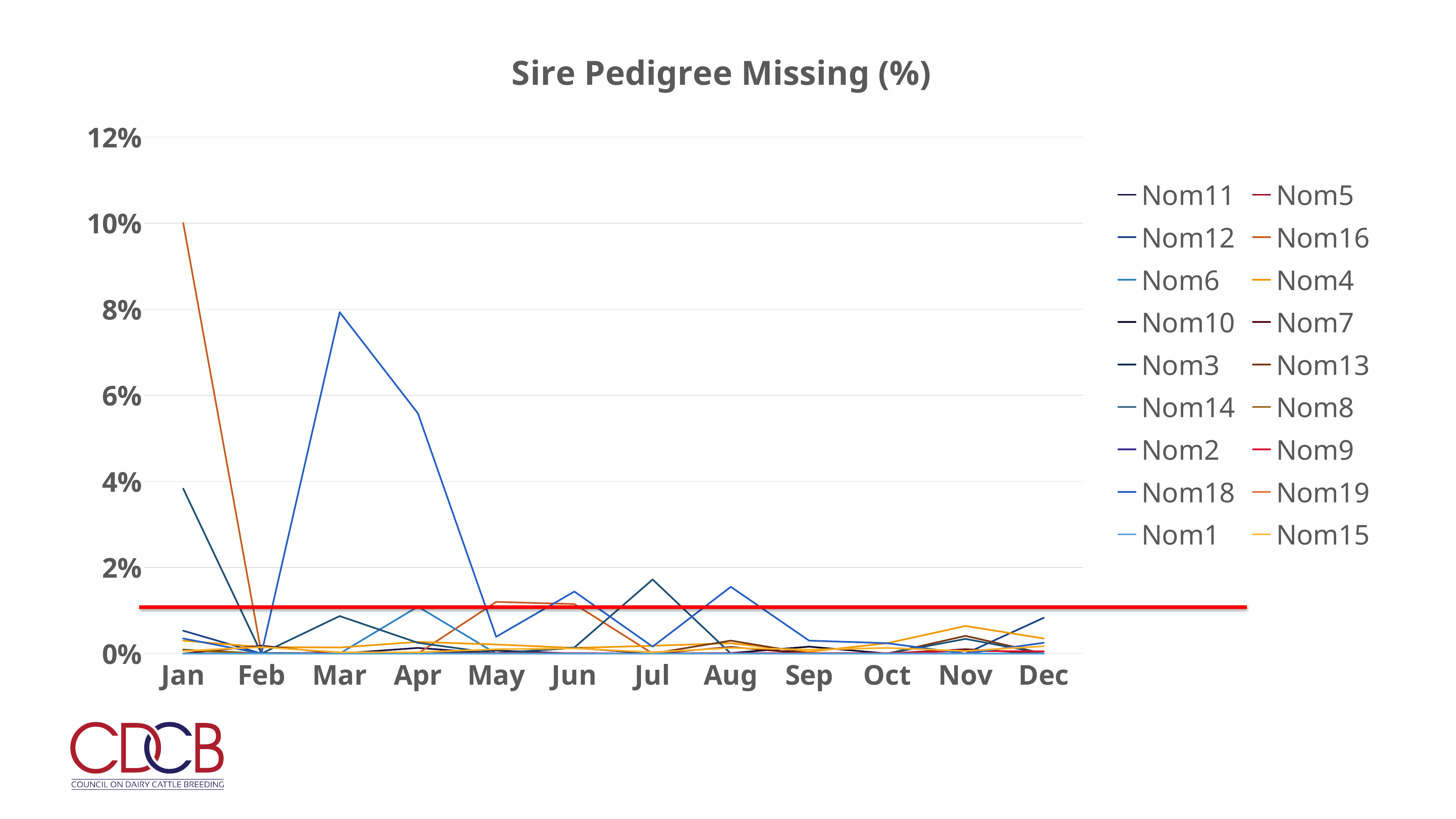
How many series does the chart's legend list? 18 Is the highest value plotted in Apr greater or less than 4%? greater What kind of chart is shown on the slide? line chart How many months are shown along the x axis of the chart? 12 Is the highest value plotted in Mar greater or less than 6%? greater Which month has the larger peak value, Mar or Jul? Mar What is the title of the chart? Sire Pedigree Missing (%) Is the highest value plotted in Jan greater or less than 8%? greater In which month does the highest value plotted on the chart occur? Jan What is the first series listed in the chart's legend? Nom11